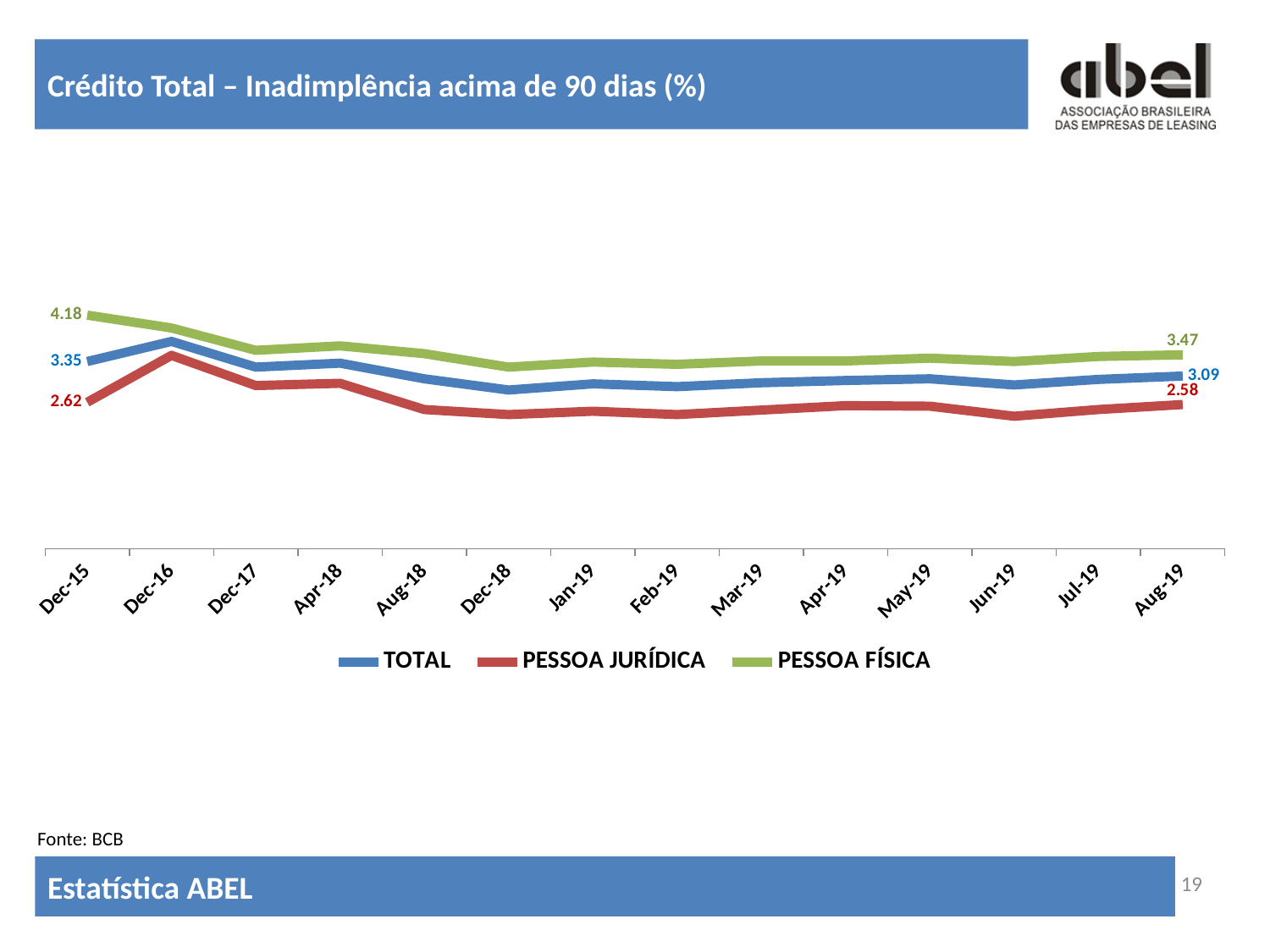
What is the title of the chart? Crédito Total – Inadimplência acima de 90 dias (%) Does the TOTAL series rise or fall from Dec-15 to Aug-19? Fall How many dates are shown on the x axis? 14 What type of chart is shown on the slide? Line chart Which series has the lowest value at Aug-19? PESSOA JURÍDICA What is the value of PESSOA JURÍDICA at Aug-19? 2.58 What is the value of TOTAL at Aug-19? 3.09 What is the difference between the PESSOA FÍSICA value at Dec-15 and at Aug-19? 0.71 What is the value of PESSOA JURÍDICA at Dec-15? 2.62 How many series does the legend list? 3 What is the value of PESSOA FÍSICA at Dec-15? 4.18 Which series has the highest value at Dec-15? PESSOA FÍSICA